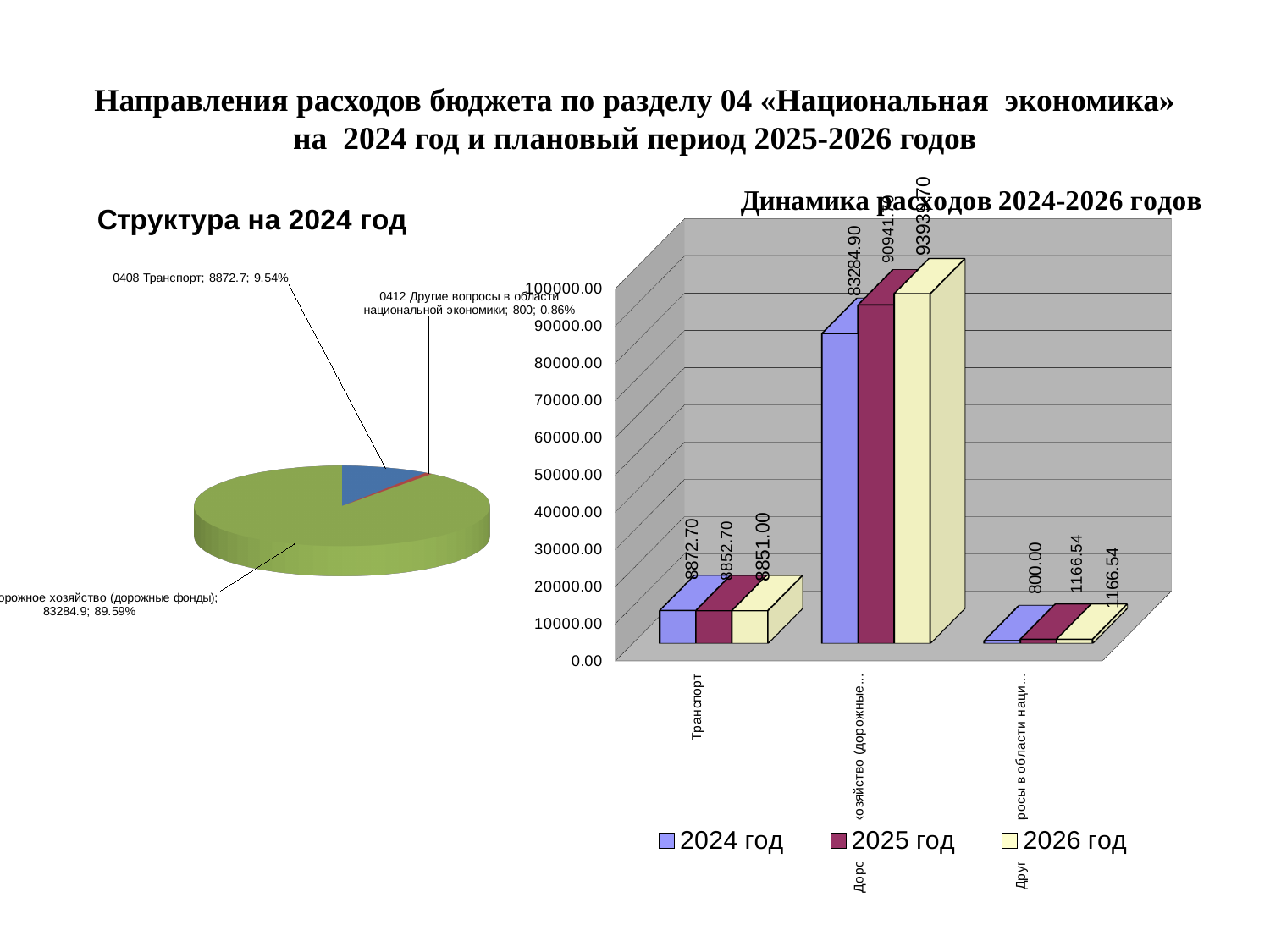
In the chart 'Динамика расходов 2024-2026 годов', what is the difference between the Транспорт values for 2024 год and 2025 год? 20.00 In the chart 'Динамика расходов 2024-2026 годов', what is the value for Другие вопросы в области национальной экономики in 2025 год? 1166.54 In the pie chart 'Структура на 2024 год', which slice is the largest? Дорожное хозяйство (дорожные фонды) In the chart 'Динамика расходов 2024-2026 годов', what is the value for Транспорт in 2024 год? 8872.70 In the pie chart 'Структура на 2024 год', what share does 0408 Транспорт have? 9.54% How many series does the legend of the chart 'Динамика расходов 2024-2026 годов' list? 3 In the chart 'Динамика расходов 2024-2026 годов', what is the value for Транспорт in 2026 год? 8851.00 What kind of chart is 'Динамика расходов 2024-2026 годов'? Bar chart In the pie chart 'Структура на 2024 год', what is the value shown for 0412 Другие вопросы в области национальной экономики? 800 In the chart 'Динамика расходов 2024-2026 годов', is the 2024 год value for Дорожное хозяйство greater or less than 80000.00? greater How many slices does the pie chart 'Структура на 2024 год' have? 3 In the pie chart 'Структура на 2024 год', which slice is the smallest? 0412 Другие вопросы в области национальной экономики